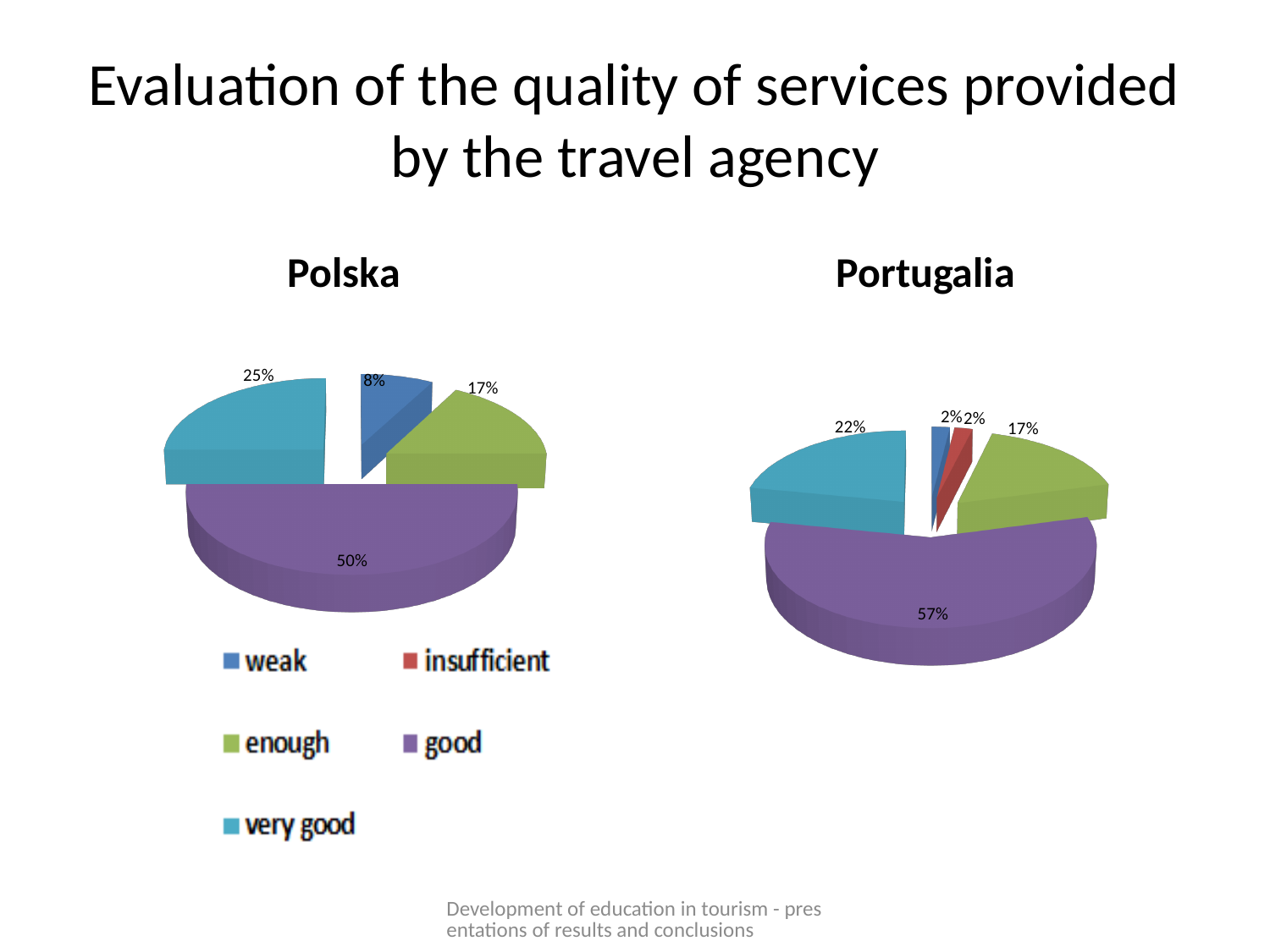
In the Portugalia chart, which rating has the largest share? good In the Polska chart, which rating has the largest share? good In the Polska chart, what share of respondents rated the services as good? 50% In the Polska chart, what percentage corresponds to the very good rating? 25% In the Portugalia chart, what share of respondents rated the services as good? 57% What type of chart is used for Polska and Portugalia? Pie chart In the Polska chart, which rating has the smallest share? weak How many rating categories does the legend list? 5 Which chart shows a larger share for very good, Polska or Portugalia? Polska How many slices are shown in the Portugalia chart? 5 What is the difference between the good share in the Portugalia chart and the good share in the Polska chart? 7% In the Portugalia chart, what percentage corresponds to the enough rating? 17%